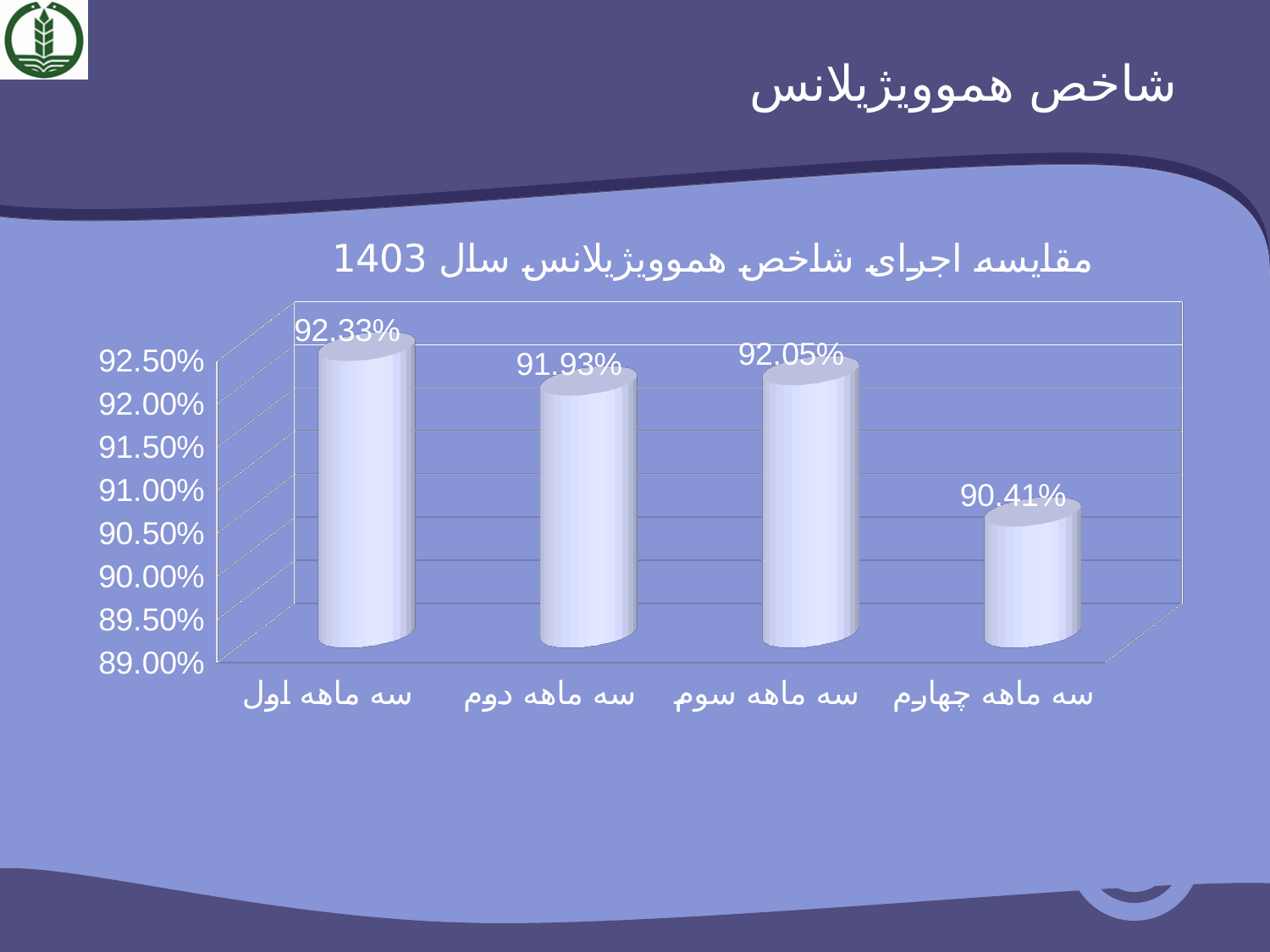
Is the value for سه ماهه چهارم greater or less than 91.00%? less What is the value for سه ماهه اول? 92.33% What is the title of the chart? مقایسه اجرای شاخص هموویژیلانس سال 1403 What is the value for سه ماهه سوم? 92.05% What kind of chart is shown on the slide? bar chart What is the value for سه ماهه چهارم? 90.41% Which quarter has the lowest value? سه ماهه چهارم Which is larger, the value for سه ماهه دوم or سه ماهه سوم? سه ماهه سوم Which quarter has the highest value? سه ماهه اول How many quarters are shown on the chart? 4 What is the difference between the values for سه ماهه سوم and سه ماهه دوم? 0.12% What is the difference between the values for سه ماهه اول and سه ماهه چهارم? 1.92%